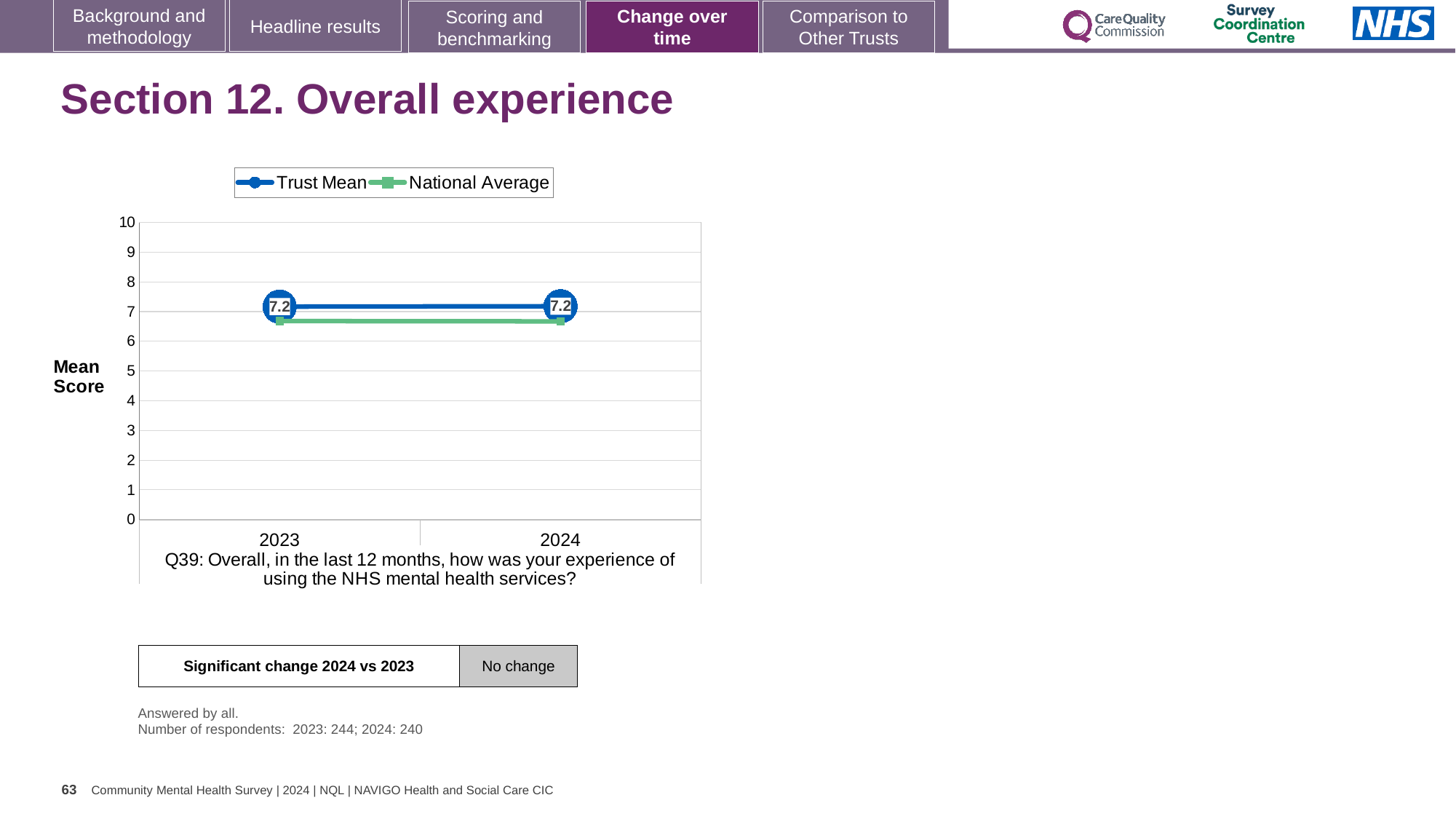
What kind of chart is shown on the slide? Line chart What is the difference between the Trust Mean in 2024 and in 2023? 0 Does the Trust Mean rise, fall or stay the same from 2023 to 2024? Stays the same How many series does the legend list? 2 Is the National Average value for 2024 greater or less than 6? greater Which series is shown in green in the legend? National Average How many years are plotted on the x axis? 2 What is the Trust Mean value for 2023? 7.2 In 2024, which is higher: the Trust Mean or the National Average? Trust Mean What is the label on the y axis of the chart? Mean Score What is the Trust Mean value for 2024? 7.2 Is the National Average value for 2023 greater or less than 7? less